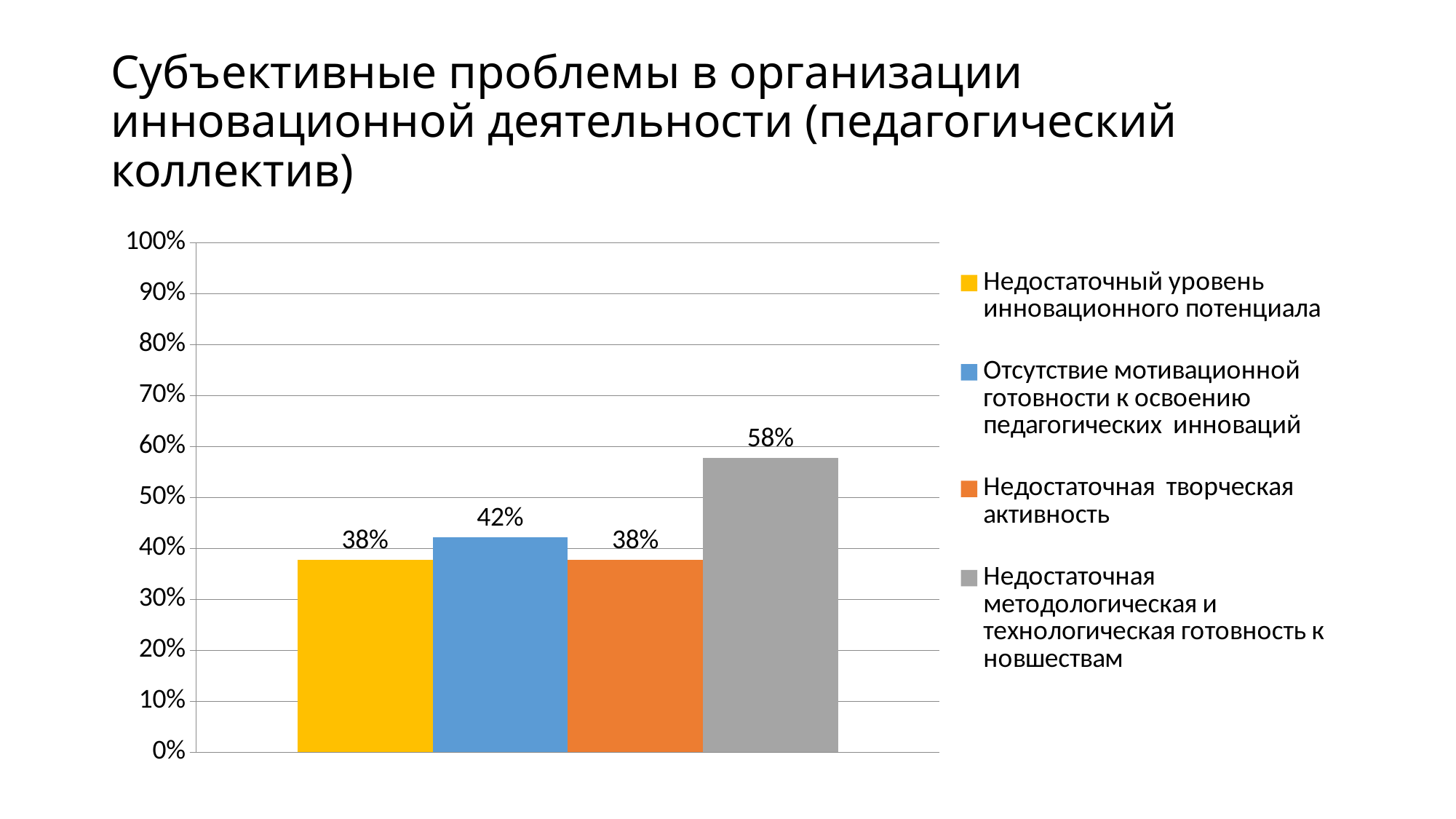
How many series does the legend list? 4 Which is larger: the value for 'Отсутствие мотивационной готовности к освоению педагогических инноваций' or the value for 'Недостаточная творческая активность'? Отсутствие мотивационной готовности к освоению педагогических инноваций Is the value for 'Недостаточная методологическая и технологическая готовность к новшествам' greater or less than 50%? greater What kind of chart is shown on the slide? bar chart How many bars are plotted in the chart? 4 What is the value for 'Недостаточная методологическая и технологическая готовность к новшествам'? 58% What is the value for 'Отсутствие мотивационной готовности к освоению педагогических инноваций'? 42% Which series has the highest value? Недостаточная методологическая и технологическая готовность к новшествам What is the difference between the values for 'Отсутствие мотивационной готовности к освоению педагогических инноваций' and 'Недостаточная творческая активность'? 4% What is the value for 'Недостаточный уровень инновационного потенциала'? 38% What is the difference between the values for 'Недостаточная методологическая и технологическая готовность к новшествам' and 'Отсутствие мотивационной готовности к освоению педагогических инноваций'? 16% What colour is the bar for 'Недостаточная творческая активность'? orange